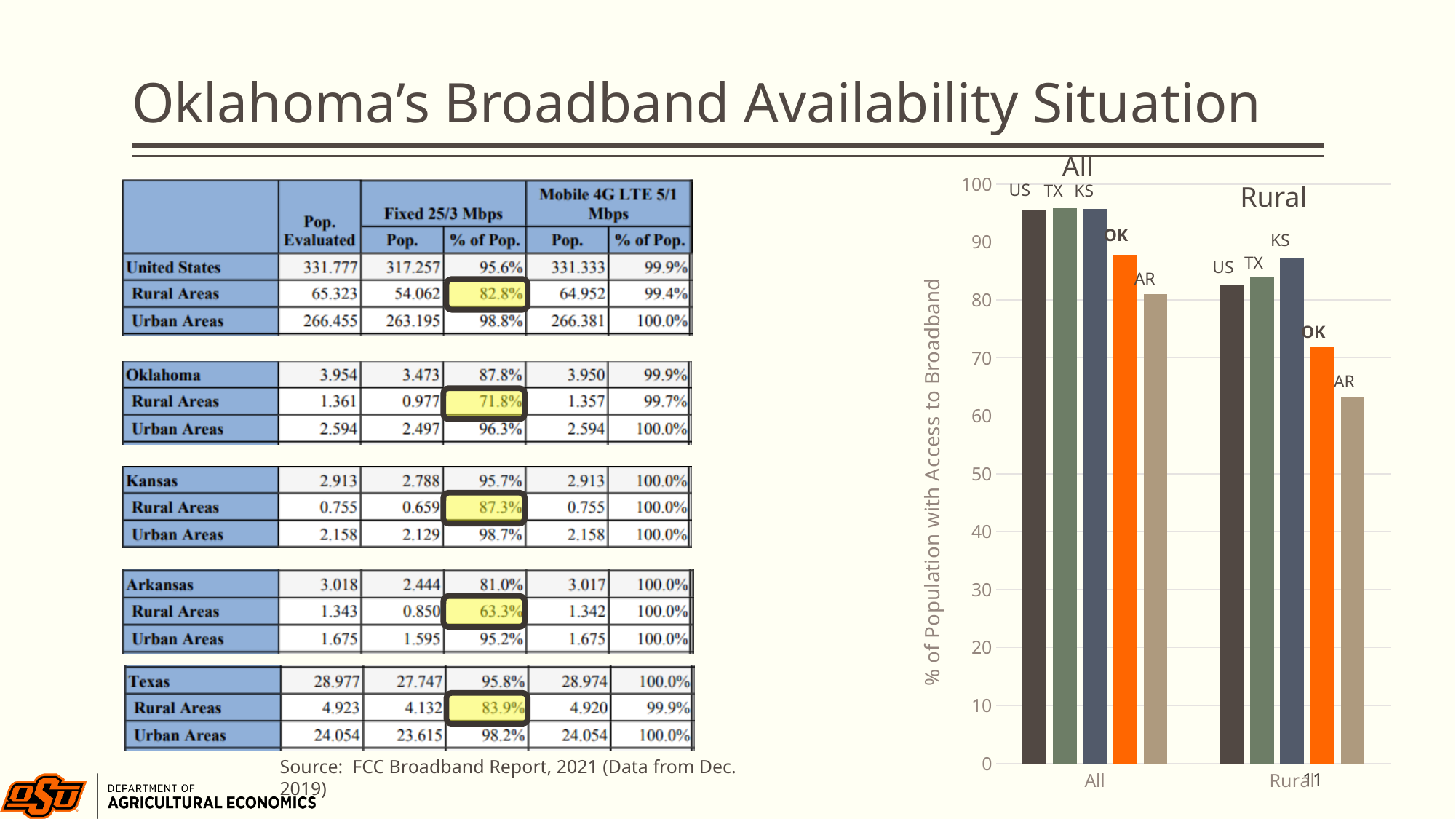
In the All group of the chart, which bar is the lowest? AR In the Rural group of the chart, which bar is the highest? KS In the Rural group of the chart, which bar is the lowest? AR Which is larger in the chart: the OK bar in the All group or the OK bar in the Rural group? All How many groups of bars does the chart on the right have? 2 What is the title of the vertical axis of the chart? % of Population with Access to Broadband What kind of chart is shown on the right side of the slide? bar chart Is the value for OK in the Rural group greater or less than 80? less How many bars are in the Rural group of the chart? 5 Is the value for AR in the Rural group greater or less than 70? less Is the value for US in the Rural group greater or less than 80? greater Do the bars for each state rise or fall from the All group to the Rural group? fall